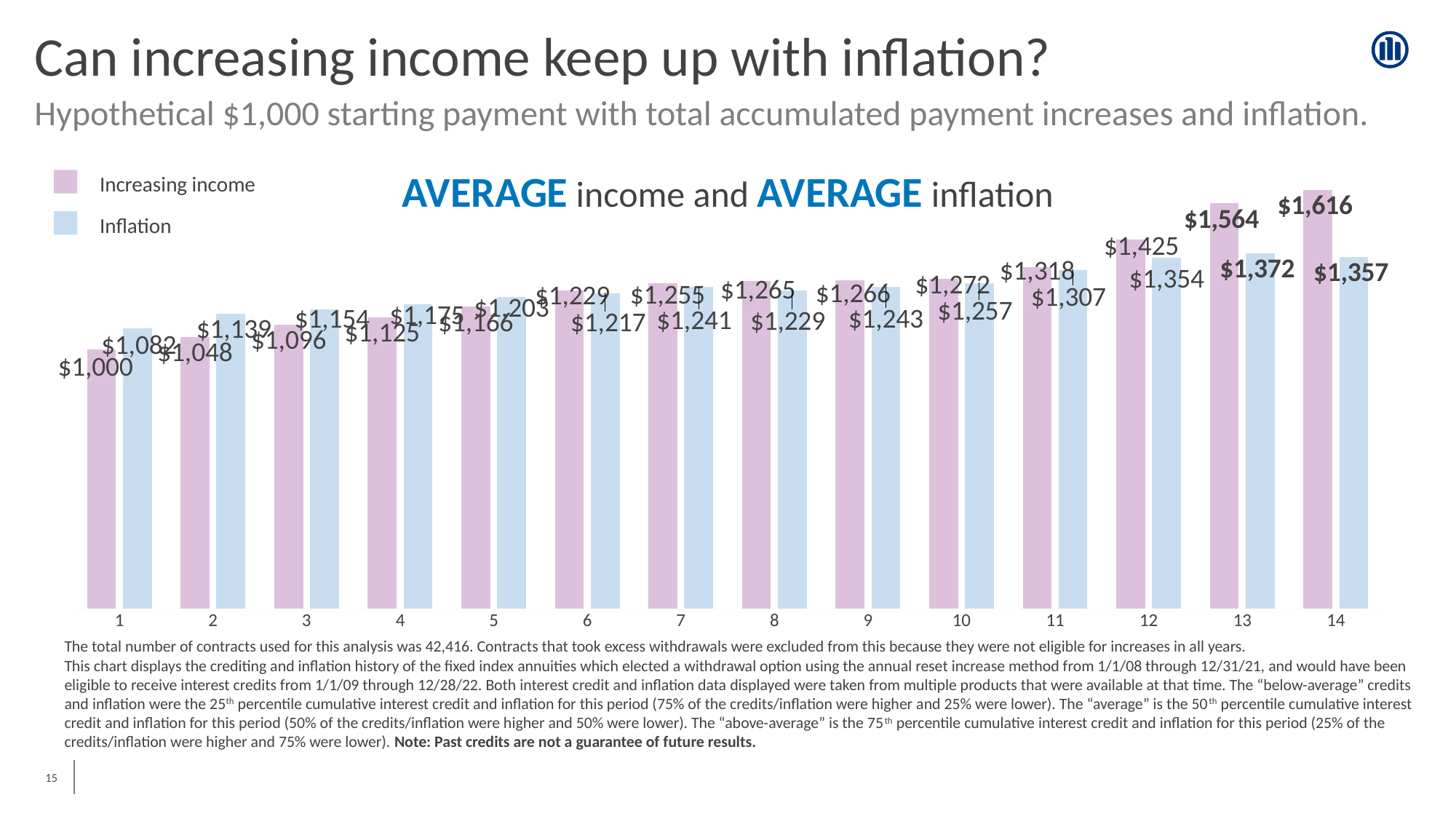
What kind of chart is shown on the slide? Bar chart What is the Inflation value at year 14? $1,357 What is the Increasing income value at year 12? $1,425 What is the Inflation value at year 1? $1,082 At year 2, which is larger: Increasing income or Inflation? Inflation How many years are shown on the x axis? 14 At which year is the Increasing income value lowest? 1 At which year is the Increasing income value highest? 14 What is the Increasing income value at year 1? $1,000 What is the difference between Increasing income and Inflation at year 14? $259 How many series does the legend list? 2 At year 13, which is larger: Increasing income or Inflation? Increasing income